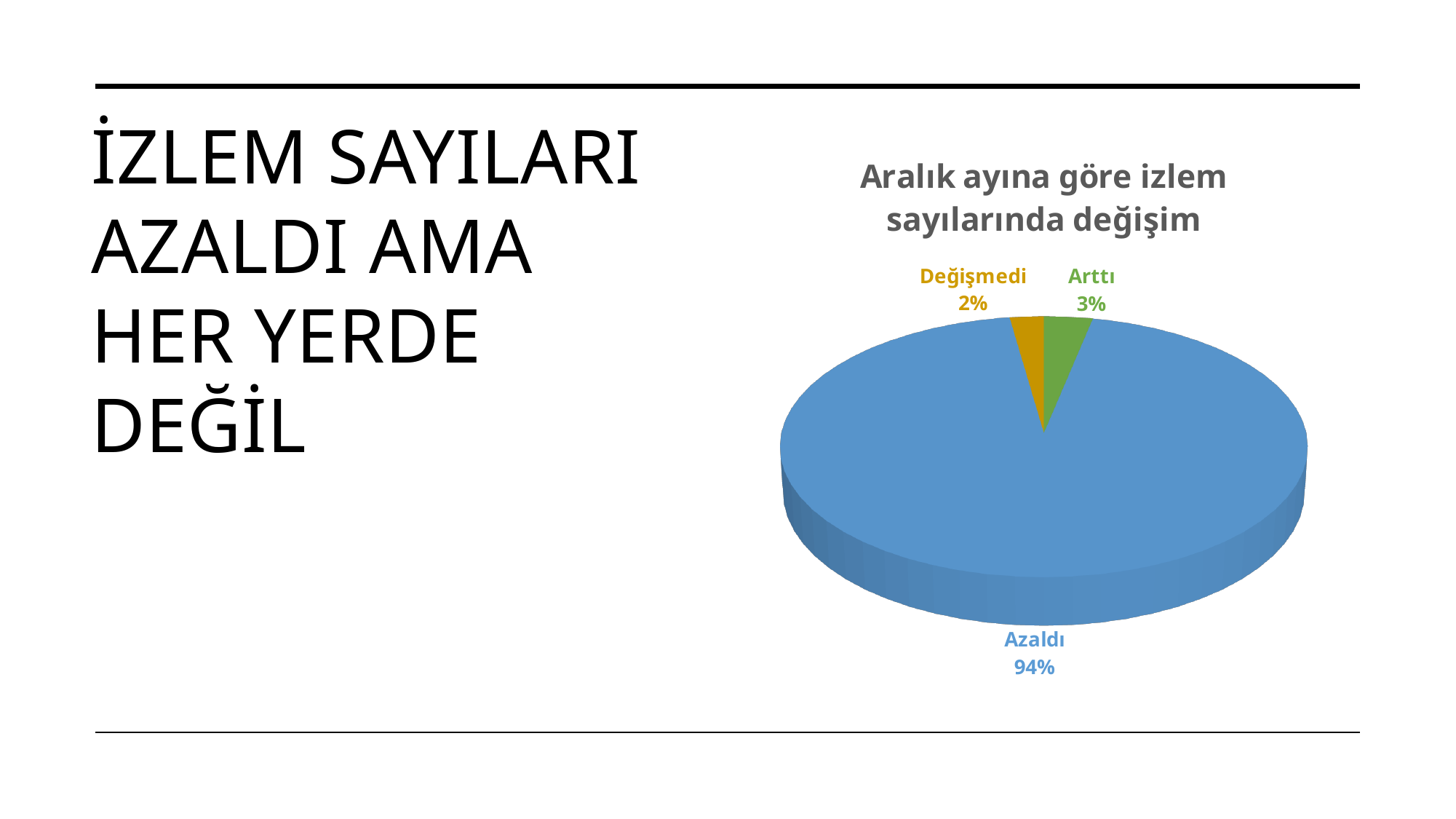
What is the difference in percentage points between Azaldı and Arttı? 91 What kind of chart is shown on the slide? pie chart What is the title of the chart? Aralık ayına göre izlem sayılarında değişim Which category has the smallest slice? Değişmedi What share of the pie does Azaldı take? 94% What share of the pie does Arttı take? 3% What colour is the Azaldı slice? blue Which is larger, the share for Arttı or the share for Değişmedi? Arttı What share of the pie does Değişmedi take? 2% How many slices does the pie chart have? 3 Which category has the largest slice? Azaldı What is the difference in percentage points between Arttı and Değişmedi? 1